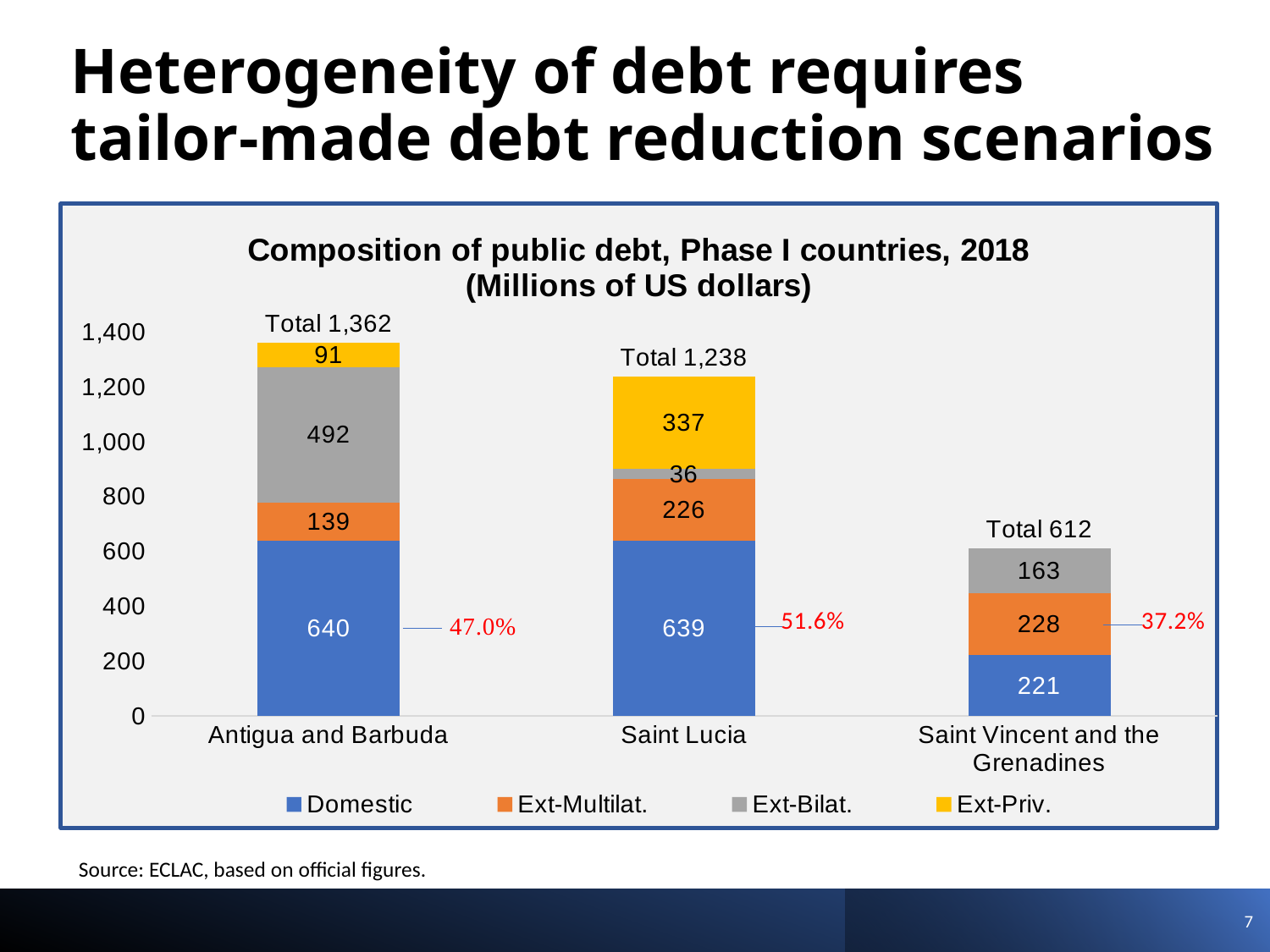
What kind of chart is shown? Stacked bar chart What is the Ext-Priv. debt value for Saint Lucia? 337 What is the Ext-Multilat. debt value for Saint Vincent and the Grenadines? 228 Which country has the lowest total public debt? Saint Vincent and the Grenadines How many countries are shown on the x axis? 3 What is the Domestic debt value for Antigua and Barbuda? 640 Which country has the highest total public debt? Antigua and Barbuda Which is larger, the Ext-Multilat. value for Saint Lucia or for Antigua and Barbuda? Saint Lucia What is the total public debt shown for Saint Lucia? 1,238 What is the Ext-Bilat. debt value for Antigua and Barbuda? 492 How many series does the legend list? 4 What is the difference between the Ext-Bilat. values for Antigua and Barbuda and Saint Lucia? 456